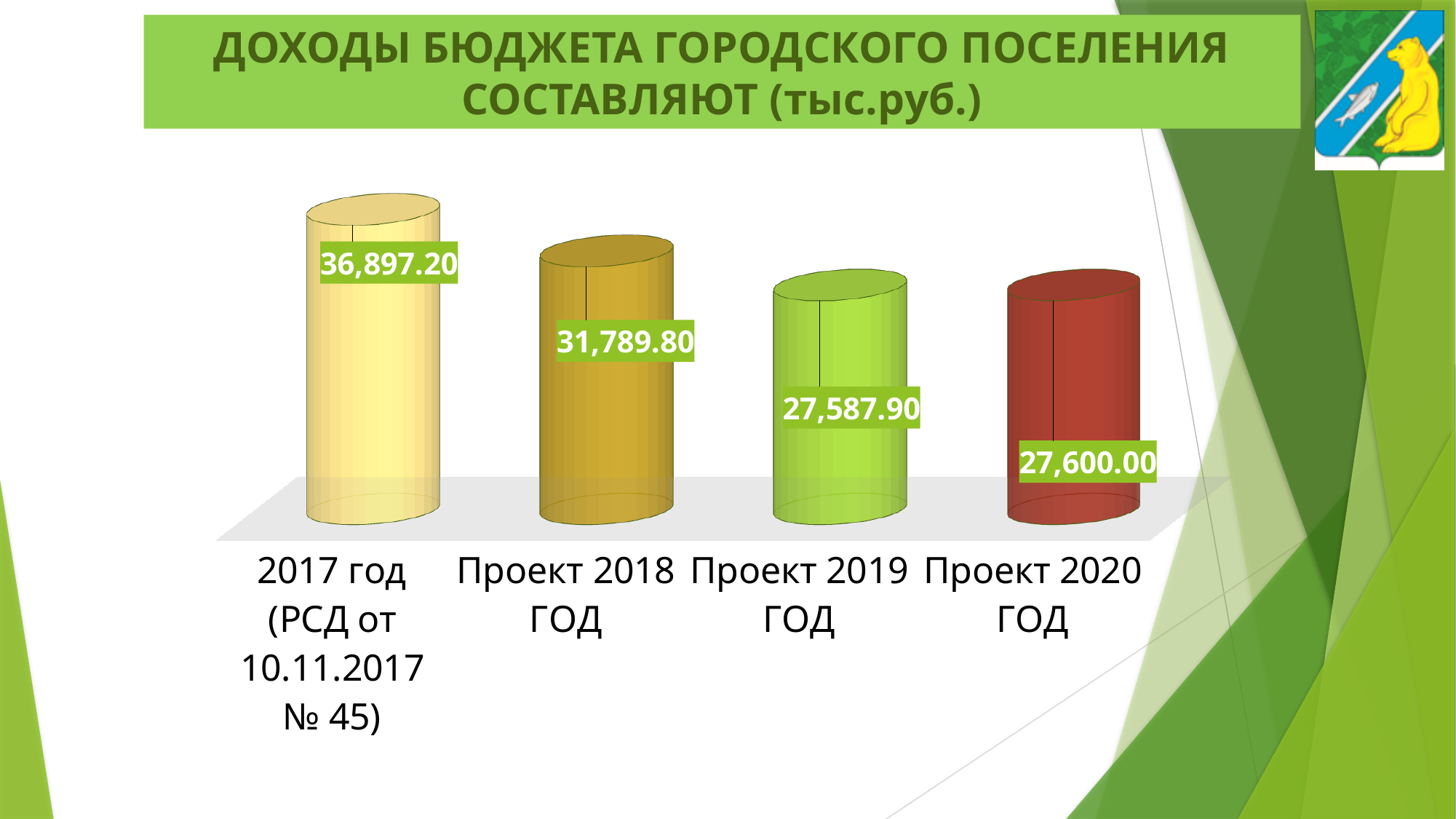
Which category has the lowest value according to the data labels? Проект 2019 ГОД What is the difference between the values for 2017 год and Проект 2018 ГОД? 5,107.40 What is the value shown for Проект 2019 ГОД? 27,587.90 What is the value shown for 2017 год (РСД от 10.11.2017 № 45)? 36,897.20 In what units are the values in the chart expressed, according to the title? тыс.руб. What is the value shown for Проект 2018 ГОД? 31,789.80 What is the value shown for Проект 2020 ГОД? 27,600.00 What is the difference between the values for Проект 2018 ГОД and Проект 2019 ГОД? 4,201.90 Which is larger according to the data labels: the value for Проект 2019 ГОД or Проект 2020 ГОД? Проект 2020 ГОД How many categories are shown in the chart? 4 What kind of chart is shown on the slide? Bar chart Which category has the highest value? 2017 год (РСД от 10.11.2017 № 45)